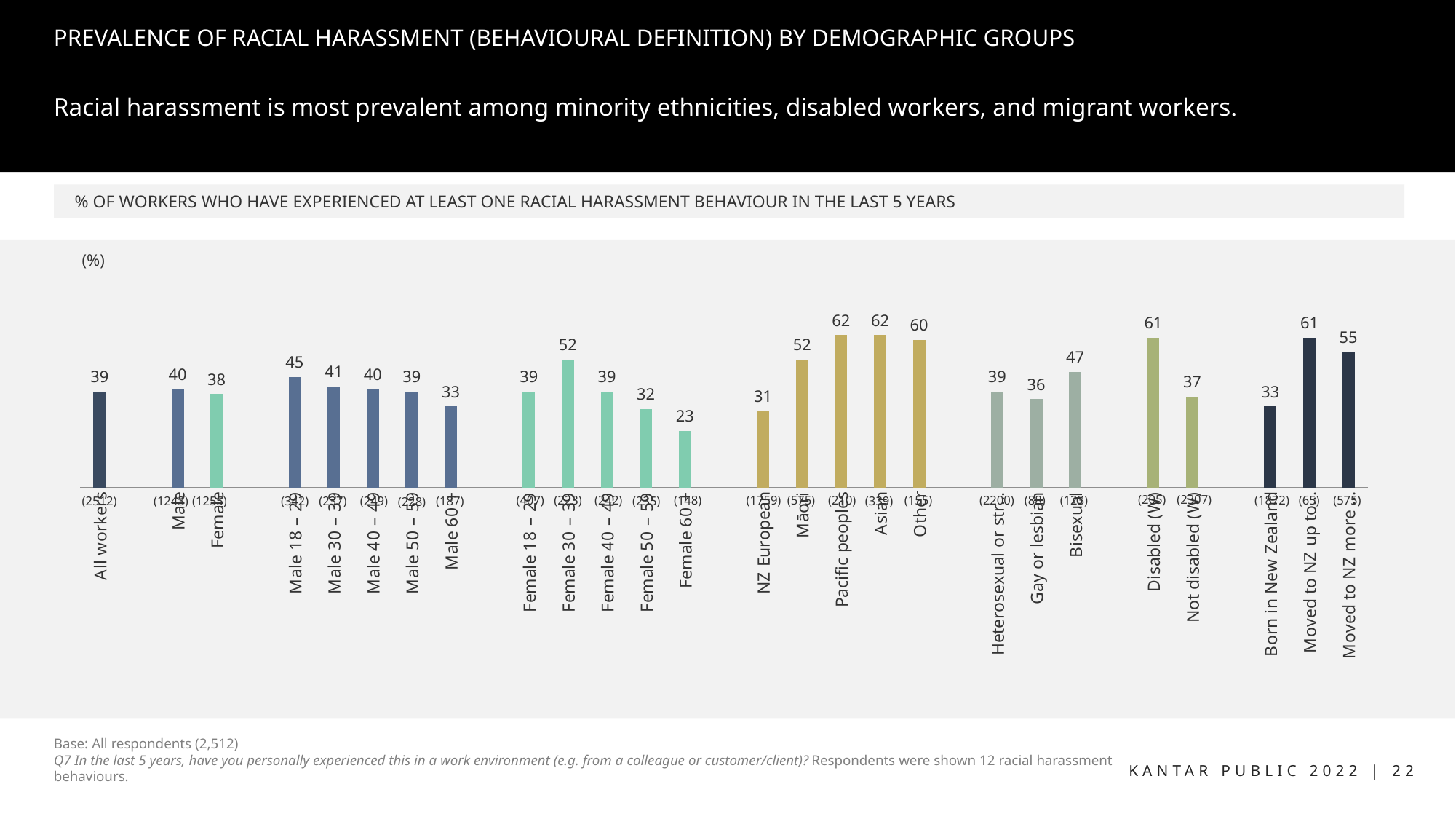
What is the value shown for Pacific peoples? 62 What kind of chart is shown on the slide? Bar chart Which has a higher value, Born in New Zealand or Moved to NZ more (recently)? Moved to NZ more What is the value shown for Bisexual workers? 47 Which category has the lowest value on the chart? Female 60+ What is the difference between the values for Disabled and Not disabled workers? 24 Across the Male age groups from youngest to oldest, do the values rise or fall? Fall What percentage of all workers have experienced at least one racial harassment behaviour in the last 5 years? 39 What is the value shown for Disabled workers? 61 Which has a higher value, Male or Female? Male What is the difference between the values for Māori and NZ European? 21 What is the highest value shown on the chart? 62